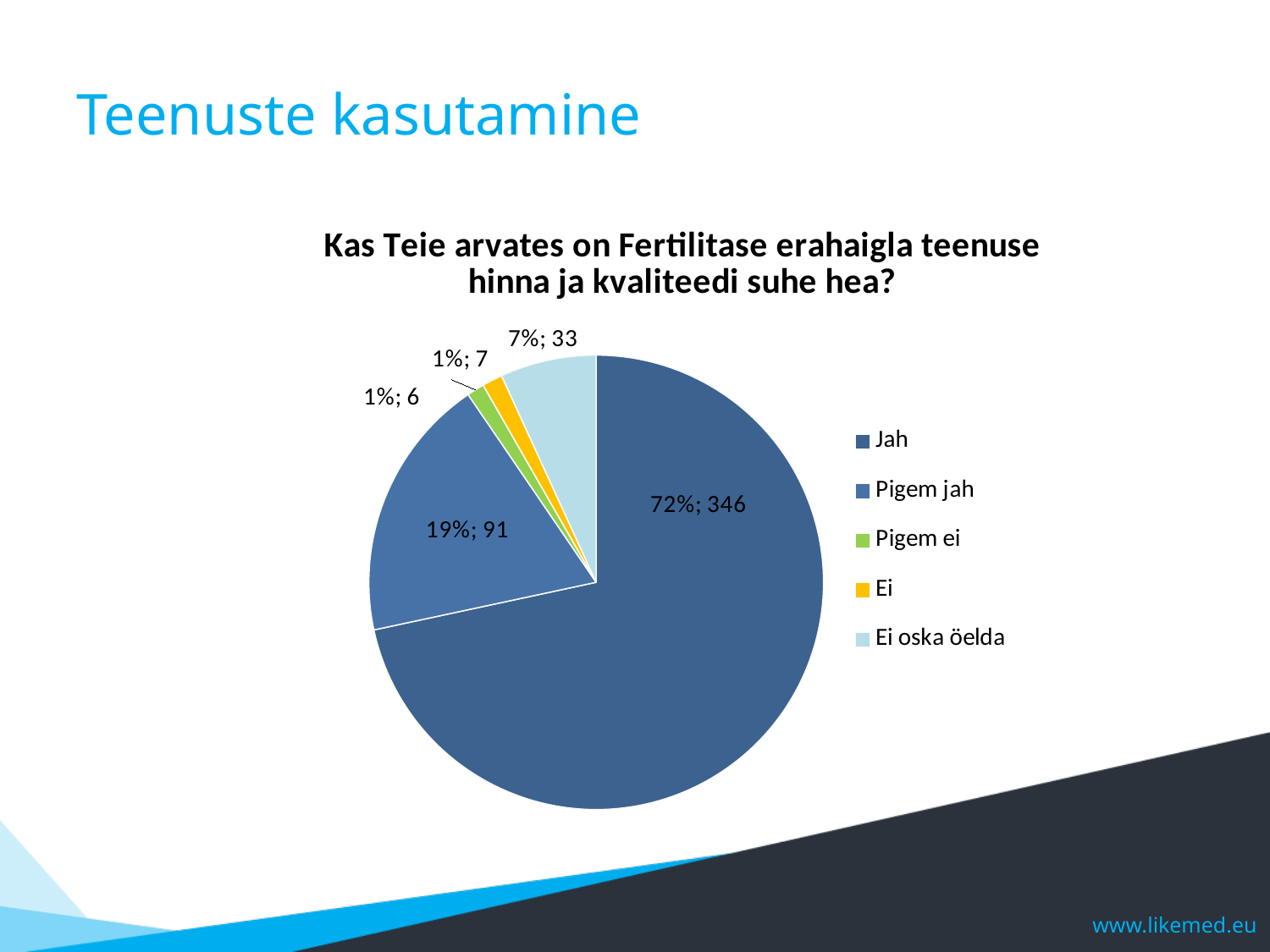
How many responses are in the "Ei oska öelda" category? 33 How many more responses does "Jah" have than "Pigem jah"? 255 How many categories does the pie chart show? 5 What type of chart is shown on the slide? Pie chart What share of responses does the "Jah" slice represent? 72% How many responses are in the "Jah" category? 346 Which category has more responses, "Pigem jah" or "Ei oska öelda"? Pigem jah What is the title of the chart? Kas Teie arvates on Fertilitase erahaigla teenuse hinna ja kvaliteedi suhe hea? What share of responses does the "Pigem jah" slice represent? 19% Which category has the largest slice of the pie? Jah How many responses are in the "Pigem jah" category? 91 What share of responses does the "Ei oska öelda" slice represent? 7%